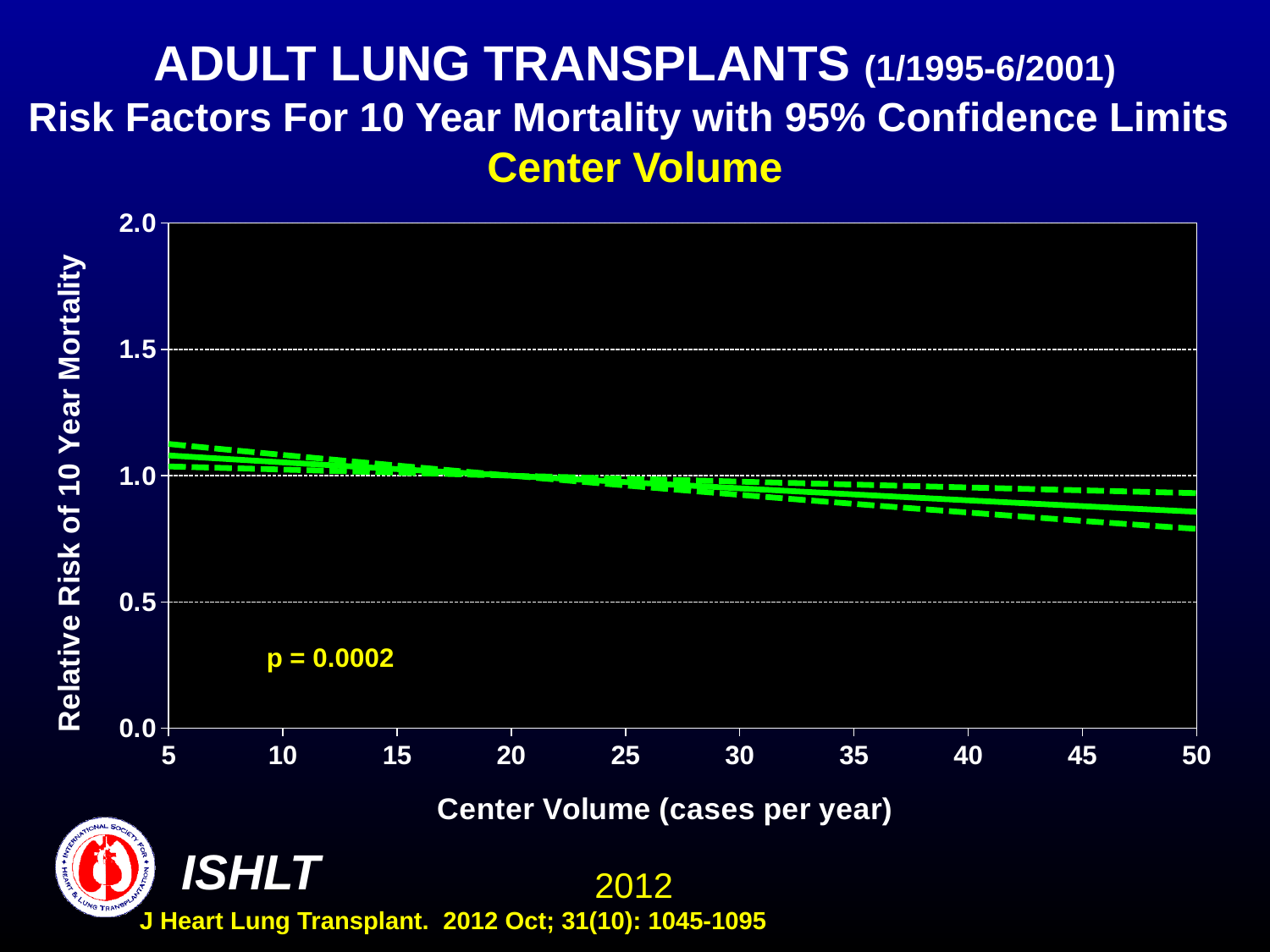
How many lines are plotted on the chart (the estimate plus its confidence limits)? 3 What is the p-value printed on the chart? p = 0.0002 What is the highest value shown on the y axis? 2.0 Is the relative risk of 10 year mortality at a center volume of 50 cases per year greater or less than 0.5? greater Is the relative risk of 10 year mortality higher at a center volume of 10 or at a center volume of 45 cases per year? 10 What kind of chart is shown on the slide? Line chart What is the range of center volume shown on the x axis? 5 to 50 Is the relative risk of 10 year mortality at a center volume of 5 cases per year greater or less than 1.5? less Is the relative risk of 10 year mortality at a center volume of 50 cases per year greater or less than 1.0? less Does the relative risk of 10 year mortality rise or fall as center volume increases along the x axis? Fall